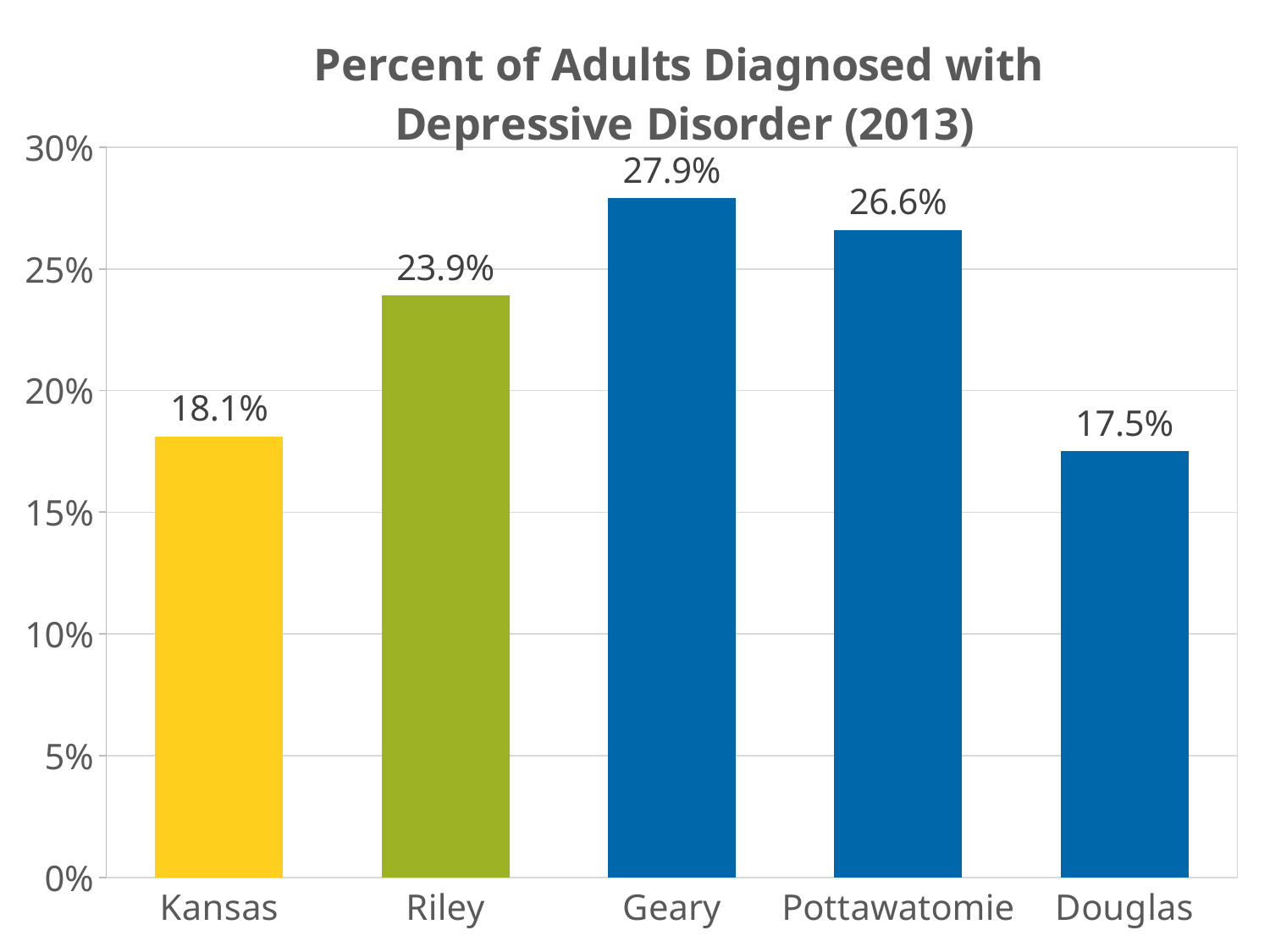
What is the difference between the values for Geary and Kansas? 9.8% What kind of chart is this? Bar chart What is the value for Kansas? 18.1% Which category has the lowest value? Douglas Which is larger, the value for Riley or the value for Pottawatomie? Pottawatomie What is the value for Douglas? 17.5% What is the value for Geary? 27.9% How many categories are shown on the chart? 5 What is the title of the chart? Percent of Adults Diagnosed with Depressive Disorder (2013) What is the value for Pottawatomie? 26.6% Which category has the highest value? Geary What is the value for Riley? 23.9%